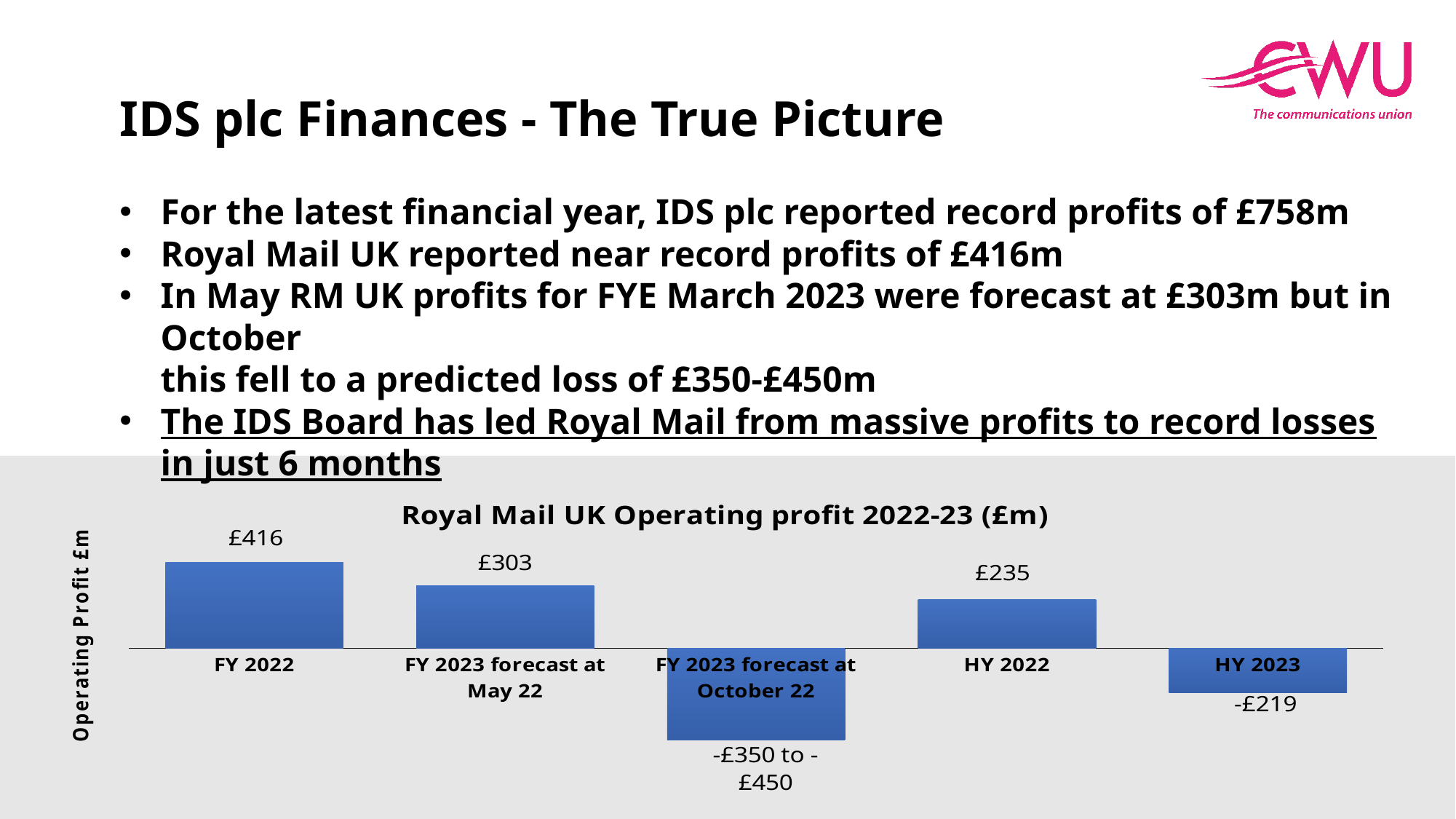
Which category has the lowest value in the chart? FY 2023 forecast at October 22 What kind of chart is shown on the slide? Bar chart How many categories are plotted in the chart? 5 What value is labelled on the bar for FY 2023 forecast at October 22? -£350 to -£450 What is the difference between the FY 2022 value and the FY 2023 forecast at May 22? £113 Which is larger, the value for HY 2022 or the value for FY 2023 forecast at May 22? FY 2023 forecast at May 22 What is the value shown for HY 2022? £235 What is the value shown for HY 2023? -£219 What is the title of the chart? Royal Mail UK Operating profit 2022-23 (£m) What is the value for FY 2023 forecast at May 22? £303 Which category has the highest operating profit? FY 2022 What is the value for FY 2022 in the Royal Mail UK Operating profit chart? £416